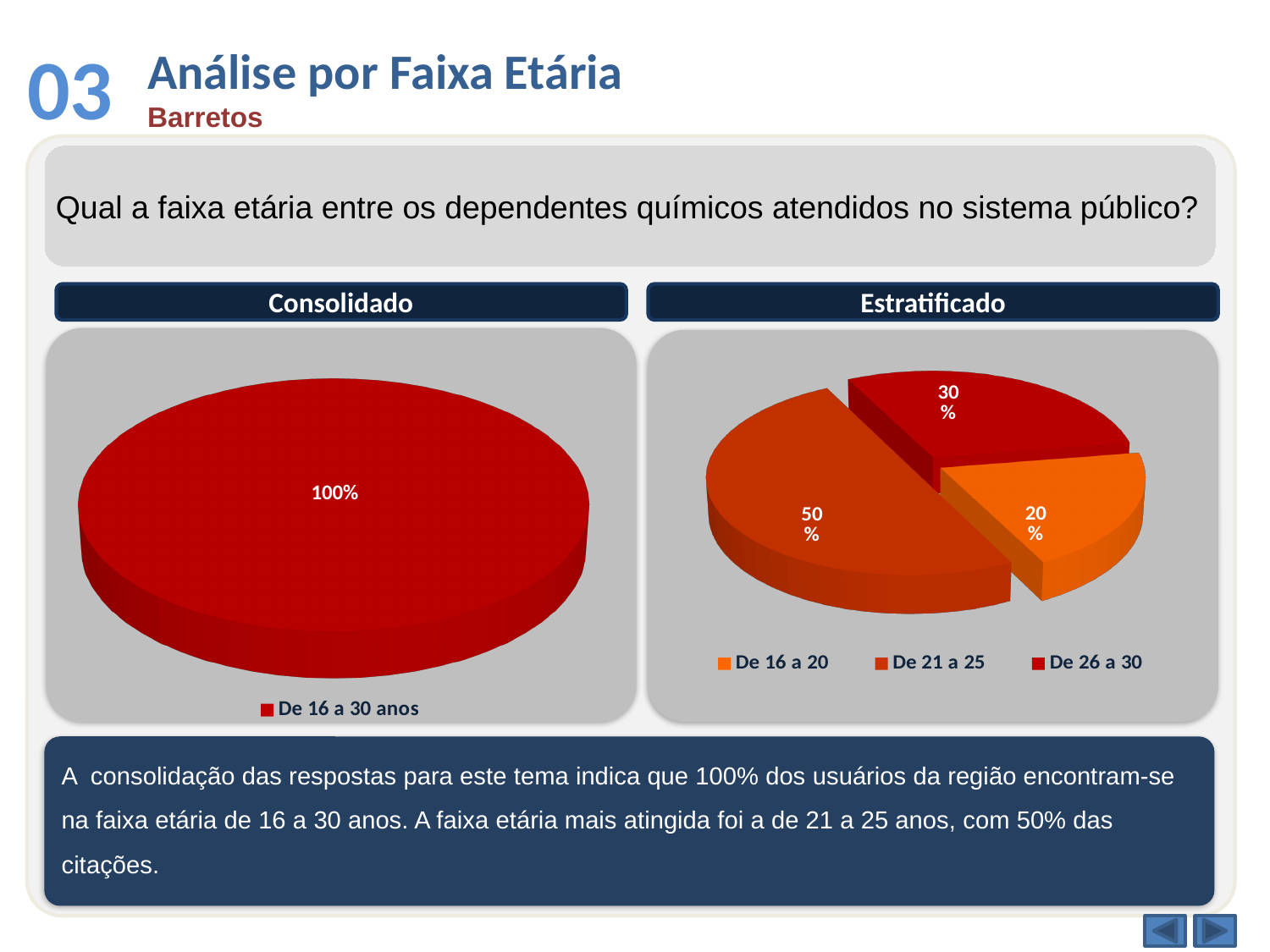
In the Estratificado chart, which is larger: De 26 a 30 or De 16 a 20? De 26 a 30 In the Estratificado chart, which category has the smallest share? De 16 a 20 In the Estratificado chart, what is the value for De 26 a 30? 30% In the Estratificado chart, what is the value for De 21 a 25? 50% In the Consolidado chart, what is the value for De 16 a 30 anos? 100% How many entries does the legend of the Estratificado chart list? 3 What kind of chart is the Consolidado chart? Pie chart In the Estratificado chart, what is the difference between the shares of De 21 a 25 and De 26 a 30? 20% What is the legend entry of the Consolidado chart? De 16 a 30 anos In the Estratificado chart, which category has the largest share? De 21 a 25 In the Estratificado chart, what is the value for De 16 a 20? 20% How many slices does the Estratificado chart have? 3